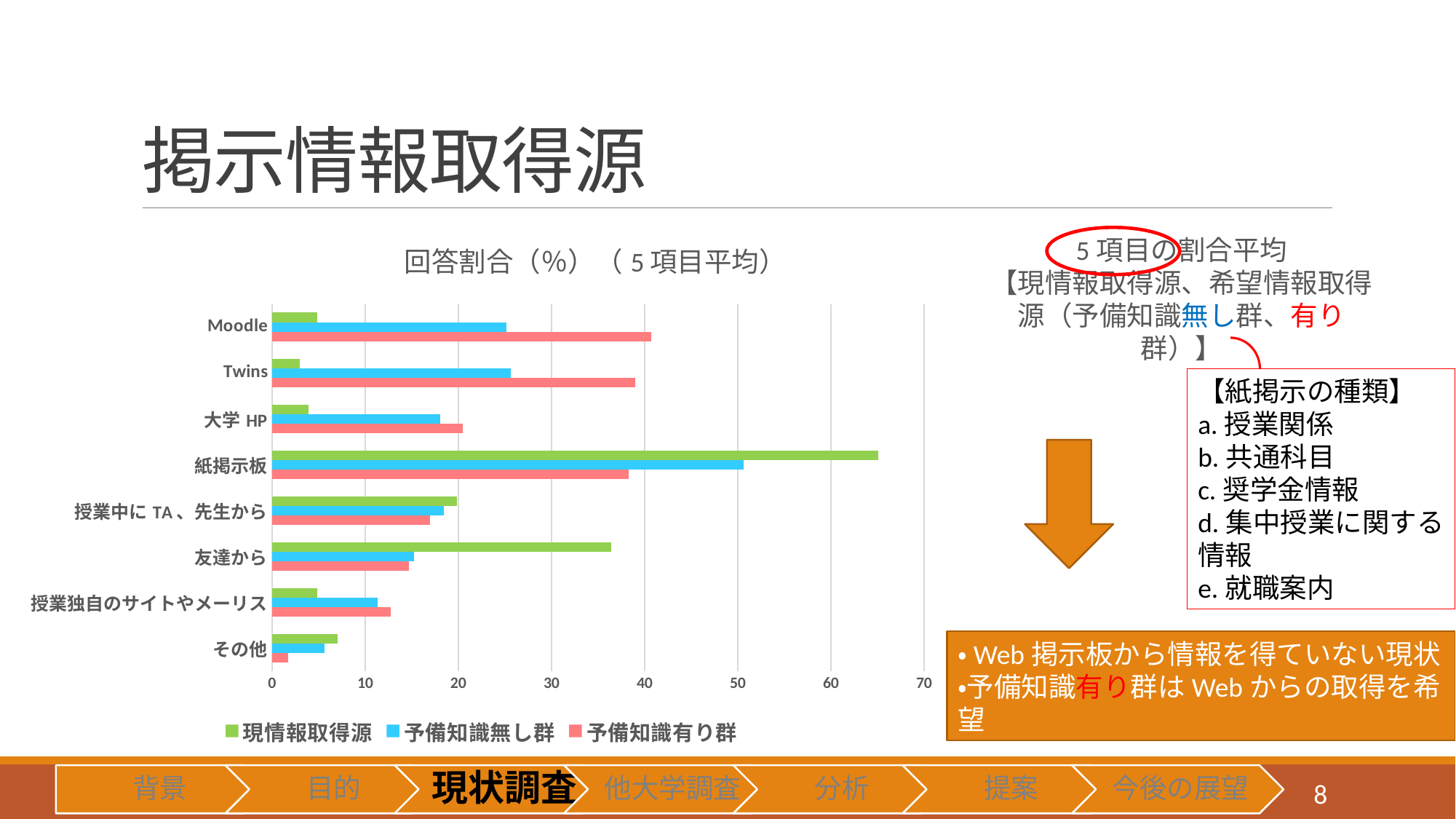
Is the 予備知識有り群 value for その他 greater or less than 10? less What kind of chart is shown on the slide? bar chart Which category has the lowest value for the 予備知識有り群 series? その他 For Moodle, which series has the larger value: 現情報取得源 or 予備知識有り群? 予備知識有り群 How many categories are plotted on the chart? 8 Which category has the highest value for the 現情報取得源 series? 紙掲示板 What is the title of the chart? 回答割合（%）（5項目平均） Which category has the highest value for the 予備知識無し群 series? 紙掲示板 For 紙掲示板, which series has the larger value: 現情報取得源 or 予備知識有り群? 現情報取得源 How many series does the chart legend list? 3 Is the 現情報取得源 value for 紙掲示板 greater or less than 60? greater Is the 現情報取得源 value for 友達から greater or less than 30? greater